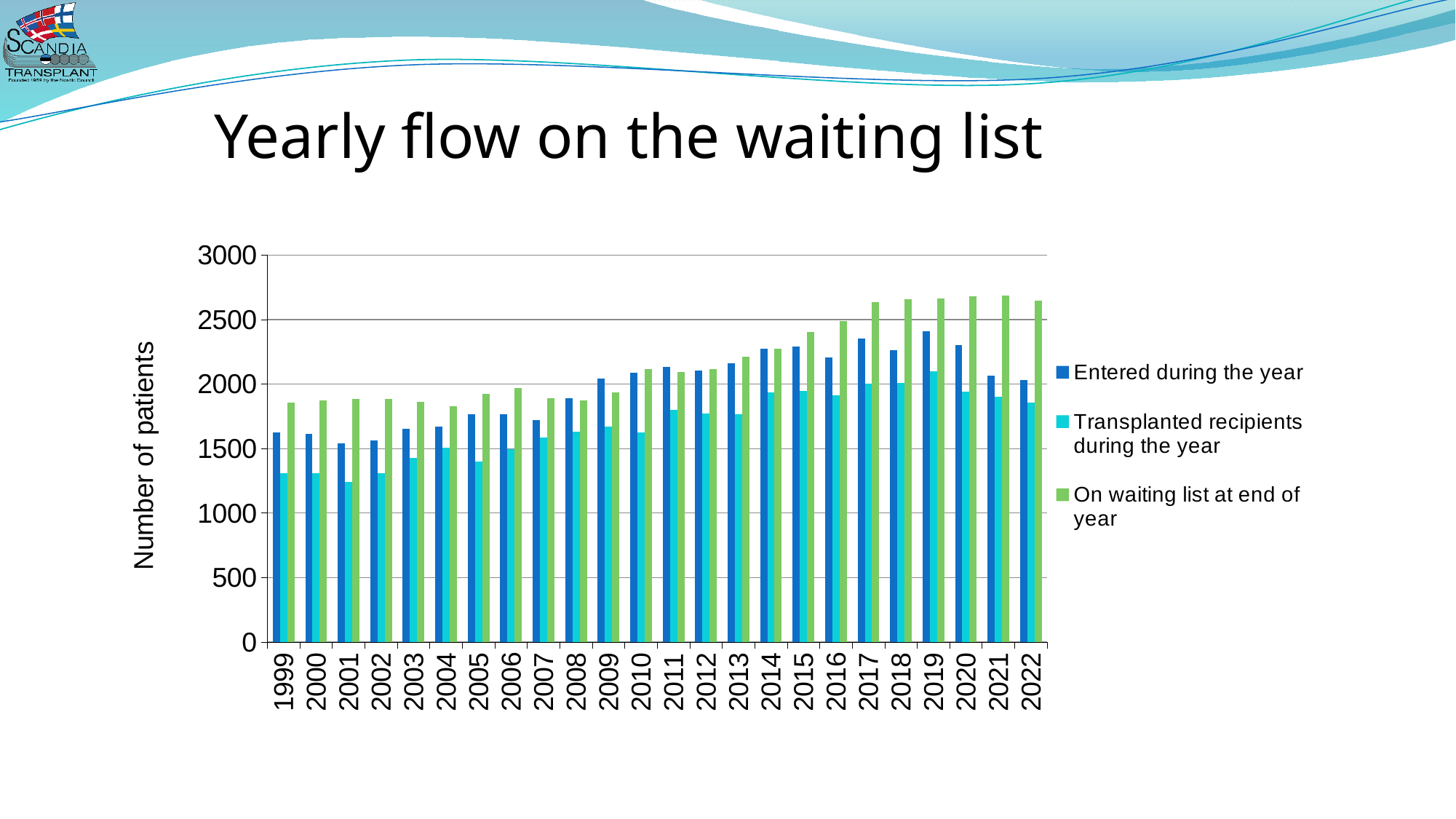
How many years are shown on the x axis? 24 In which year is 'Transplanted recipients during the year' lowest? 2001 Is the value for 'On waiting list at end of year' in 2021 greater or less than 2500? greater What kind of chart is shown on the slide? bar chart Is the value for 'Transplanted recipients during the year' in 2001 greater or less than 1500? less Is the value for 'Entered during the year' in 2019 greater or less than 2500? less In which year is 'Entered during the year' highest? 2019 How many series does the legend list? 3 What is the label of the y axis? Number of patients Which series is shown in green? On waiting list at end of year In 2005, which is larger: 'On waiting list at end of year' or 'Entered during the year'? On waiting list at end of year